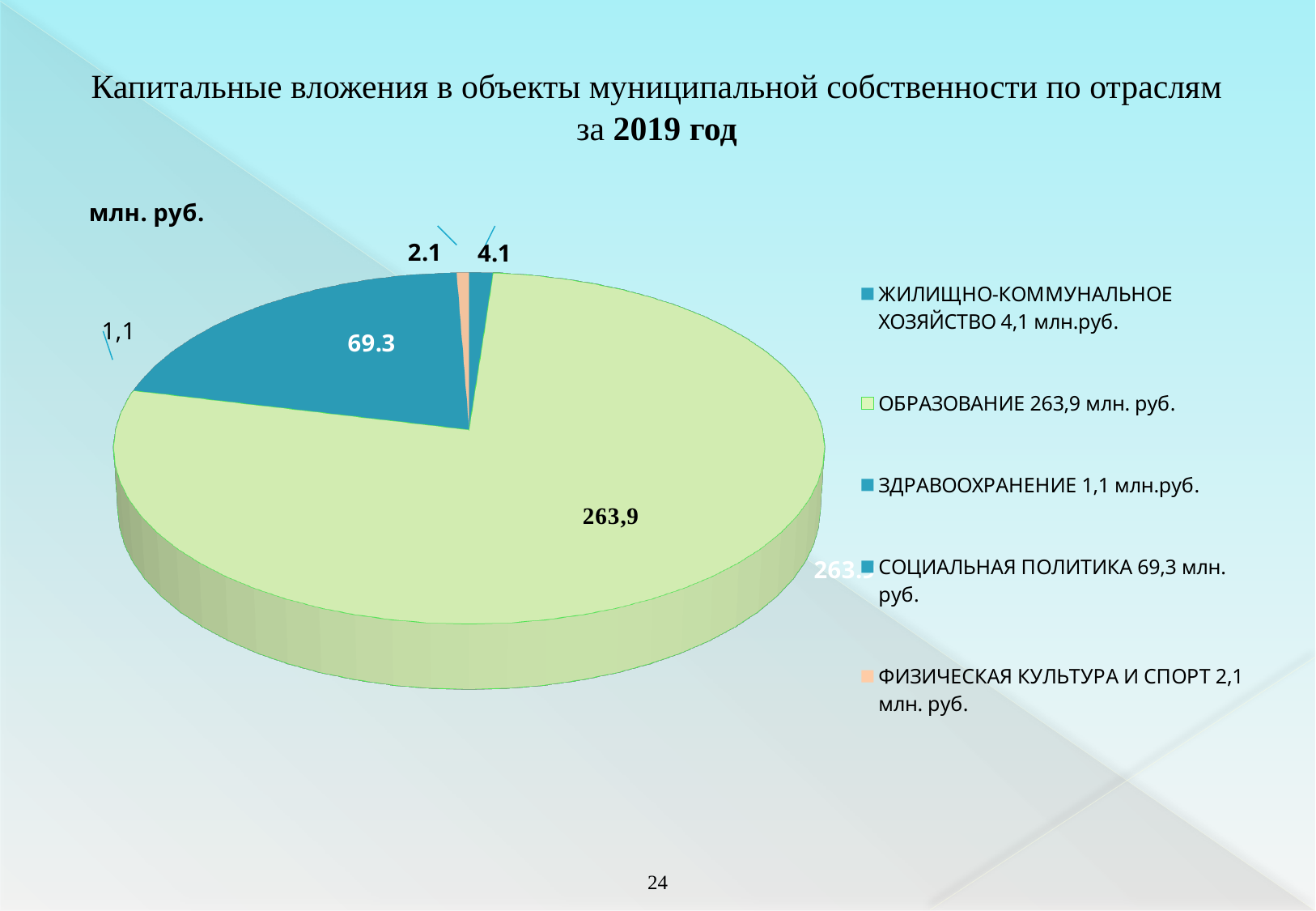
What is the value for ЗДРАВООХРАНЕНИЕ? 1,1 млн.руб. What is the difference between the values for ОБРАЗОВАНИЕ and СОЦИАЛЬНАЯ ПОЛИТИКА? 194,6 млн. руб. What type of chart is shown on the slide? Pie chart What is the value for ФИЗИЧЕСКАЯ КУЛЬТУРА И СПОРТ? 2,1 млн. руб. How many categories does the legend of the pie chart list? 5 Which category has the largest slice of the pie? ОБРАЗОВАНИЕ What unit is stated for the values in the chart? млн. руб. What is the value for ЖИЛИЩНО-КОММУНАЛЬНОЕ ХОЗЯЙСТВО? 4,1 млн.руб. What is the value for СОЦИАЛЬНАЯ ПОЛИТИКА? 69,3 млн. руб. Which is larger, the value for ЖИЛИЩНО-КОММУНАЛЬНОЕ ХОЗЯЙСТВО or the value for ФИЗИЧЕСКАЯ КУЛЬТУРА И СПОРТ? ЖИЛИЩНО-КОММУНАЛЬНОЕ ХОЗЯЙСТВО Which category has the smallest slice of the pie? ЗДРАВООХРАНЕНИЕ What is the value for ОБРАЗОВАНИЕ? 263,9 млн. руб.